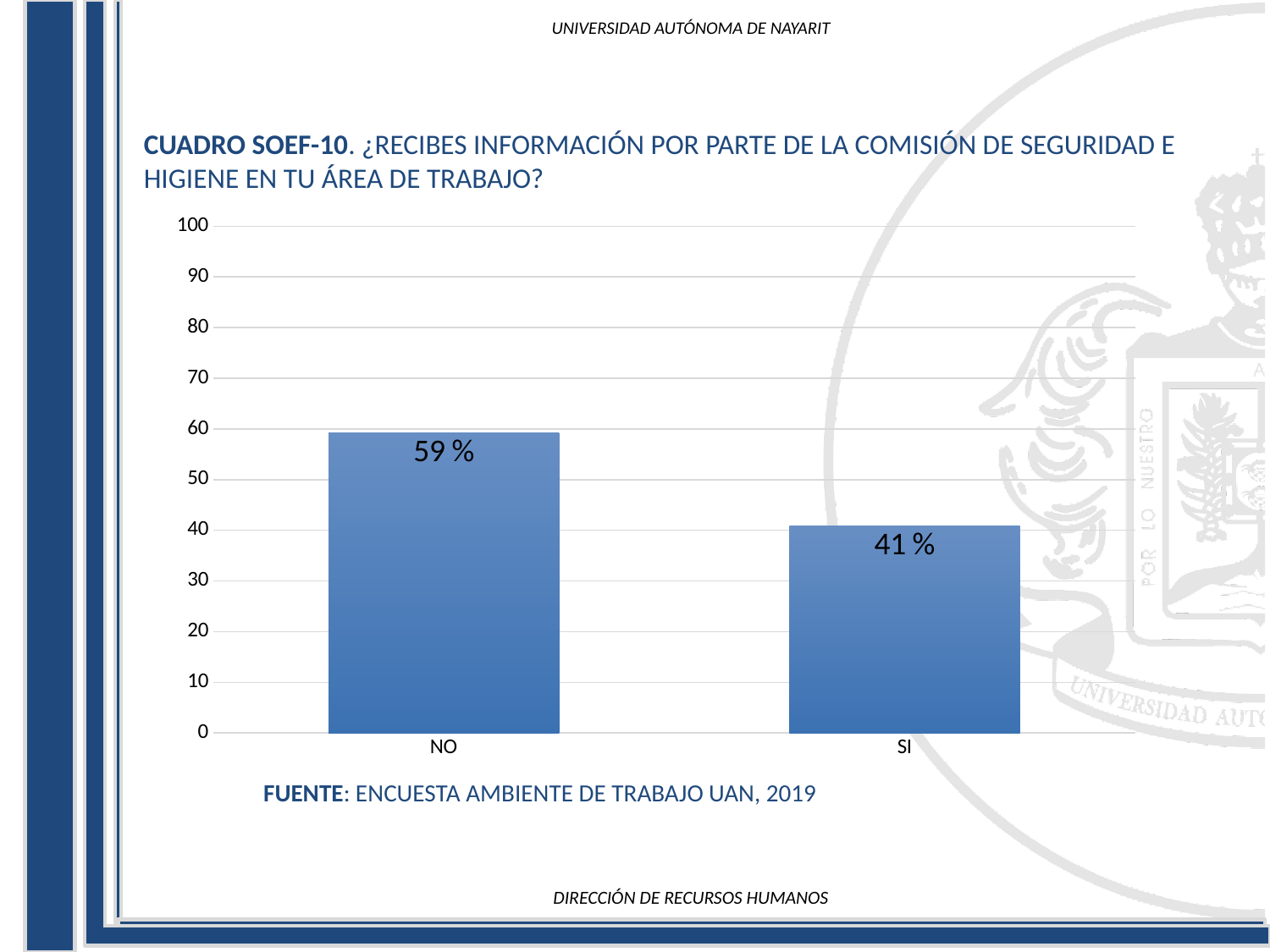
Which category has the highest value? NO How many categories are shown on the x axis? 2 Is the value for SI greater or less than 50? less What source is cited below the chart? ENCUESTA AMBIENTE DE TRABAJO UAN, 2019 What is the value for SI? 41 % What is the difference between the values for NO and SI? 18 % Which category has the lowest value? SI Is the value for NO greater or less than 50? greater What is the maximum value shown on the y axis? 100 What is the value for NO? 59 % What kind of chart is shown on the slide? bar chart Which is larger, the value for NO or the value for SI? NO